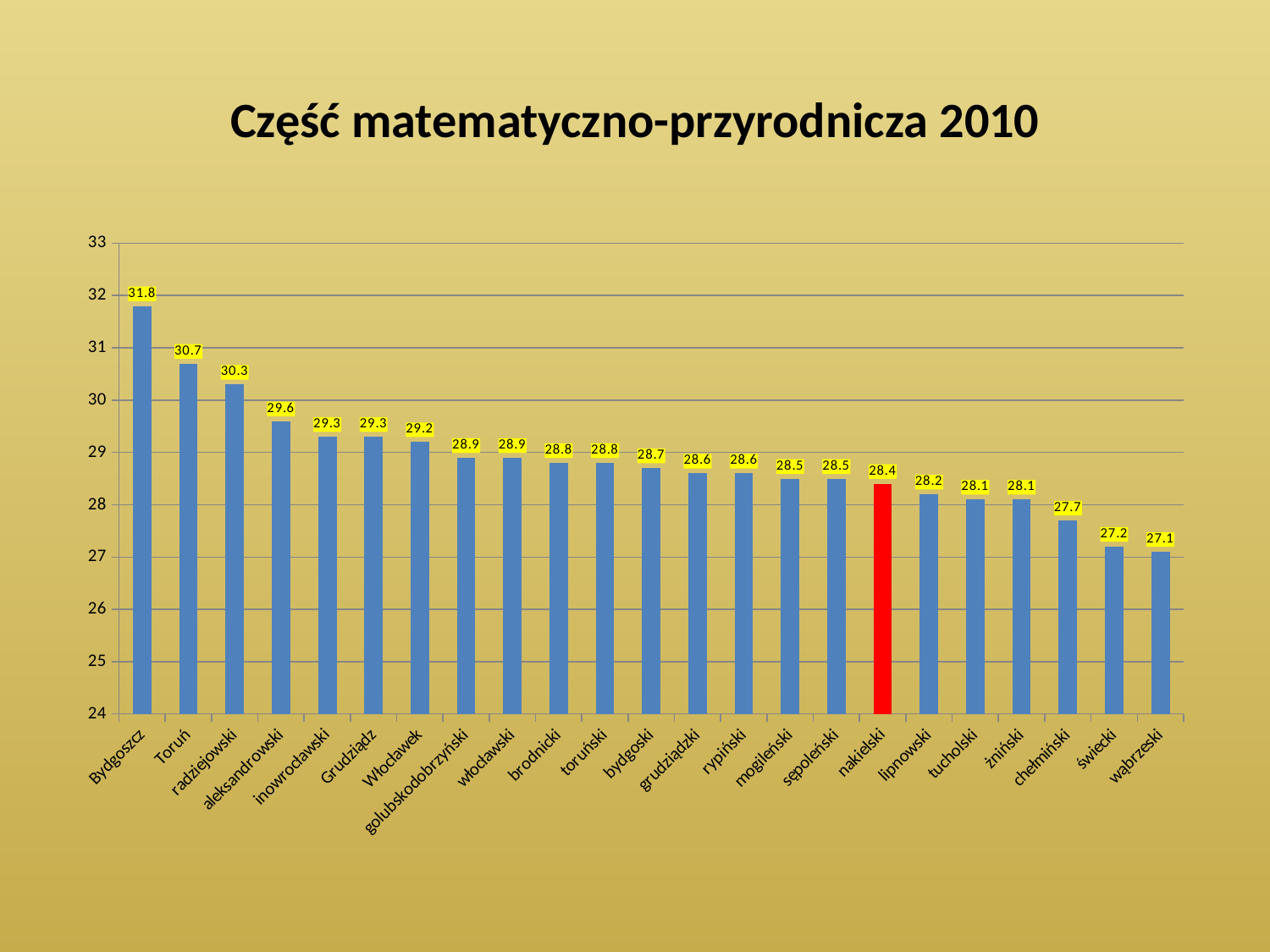
What kind of chart is shown on the slide? bar chart How many categories are shown on the x axis? 23 Which bar is coloured red instead of blue? nakielski What is the value for chełmiński? 27.7 What is the difference between the values for Toruń and radziejowski? 0.4 What is the value for nakielski? 28.4 What is the value for Bydgoszcz? 31.8 Is the value for świecki greater or less than 28? less Which is larger, the value for aleksandrowski or the value for lipnowski? aleksandrowski Which category has the highest value? Bydgoszcz Which category has the lowest value? wąbrzeski What is the difference between the values for Bydgoszcz and wąbrzeski? 4.7